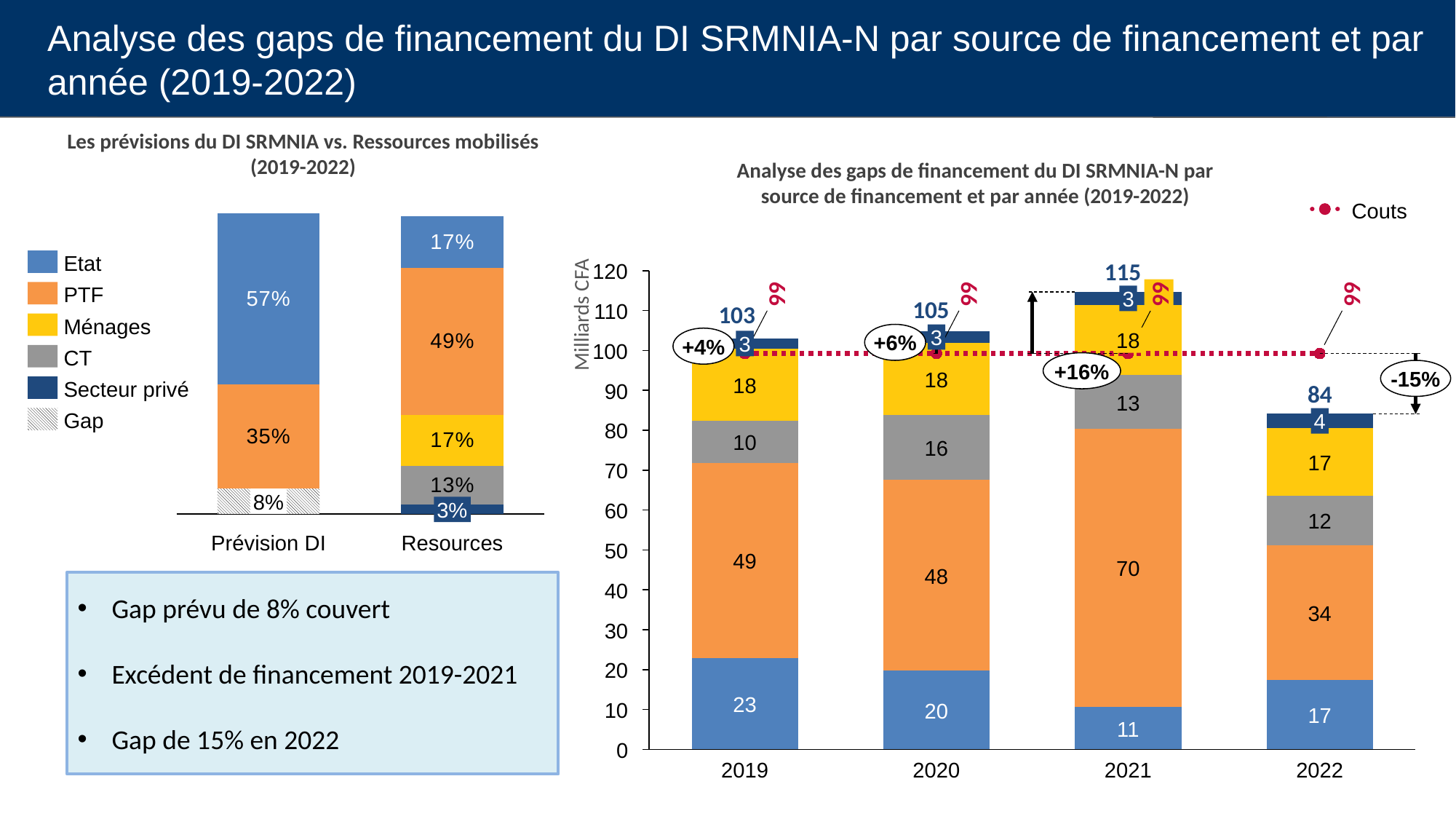
In the right chart 'Analyse des gaps de financement du DI SRMNIA-N', is the bottom blue segment larger in 2019 or in 2021? 2019 In the right chart 'Analyse des gaps de financement du DI SRMNIA-N', which year has the lowest total? 2022 In the left chart 'Les prévisions du DI SRMNIA vs. Ressources mobilisés', what is the PTF share of the Resources bar? 49% In the left chart 'Les prévisions du DI SRMNIA vs. Ressources mobilisés', what percentage does the Gap segment of the Prévision DI bar show? 8% In the left chart 'Les prévisions du DI SRMNIA vs. Ressources mobilisés', how many entries does the legend list? 6 In the left chart 'Les prévisions du DI SRMNIA vs. Ressources mobilisés', what is the difference between the Etat share in the Prévision DI bar and the Etat share in the Resources bar? 40% In the right chart 'Analyse des gaps de financement du DI SRMNIA-N', what is the difference between the totals for 2021 and 2022? 31 In the right chart 'Analyse des gaps de financement du DI SRMNIA-N', what is the total labelled above the 2021 bar? 115 In the right chart 'Analyse des gaps de financement du DI SRMNIA-N', what is the value of the orange (PTF) segment for 2021? 70 What kind of chart is the right chart 'Analyse des gaps de financement du DI SRMNIA-N'? Stacked bar chart with a line In the right chart 'Analyse des gaps de financement du DI SRMNIA-N', how many years are shown on the x axis? 4 In the right chart 'Analyse des gaps de financement du DI SRMNIA-N', what value does the Couts dotted line show for each year? 99